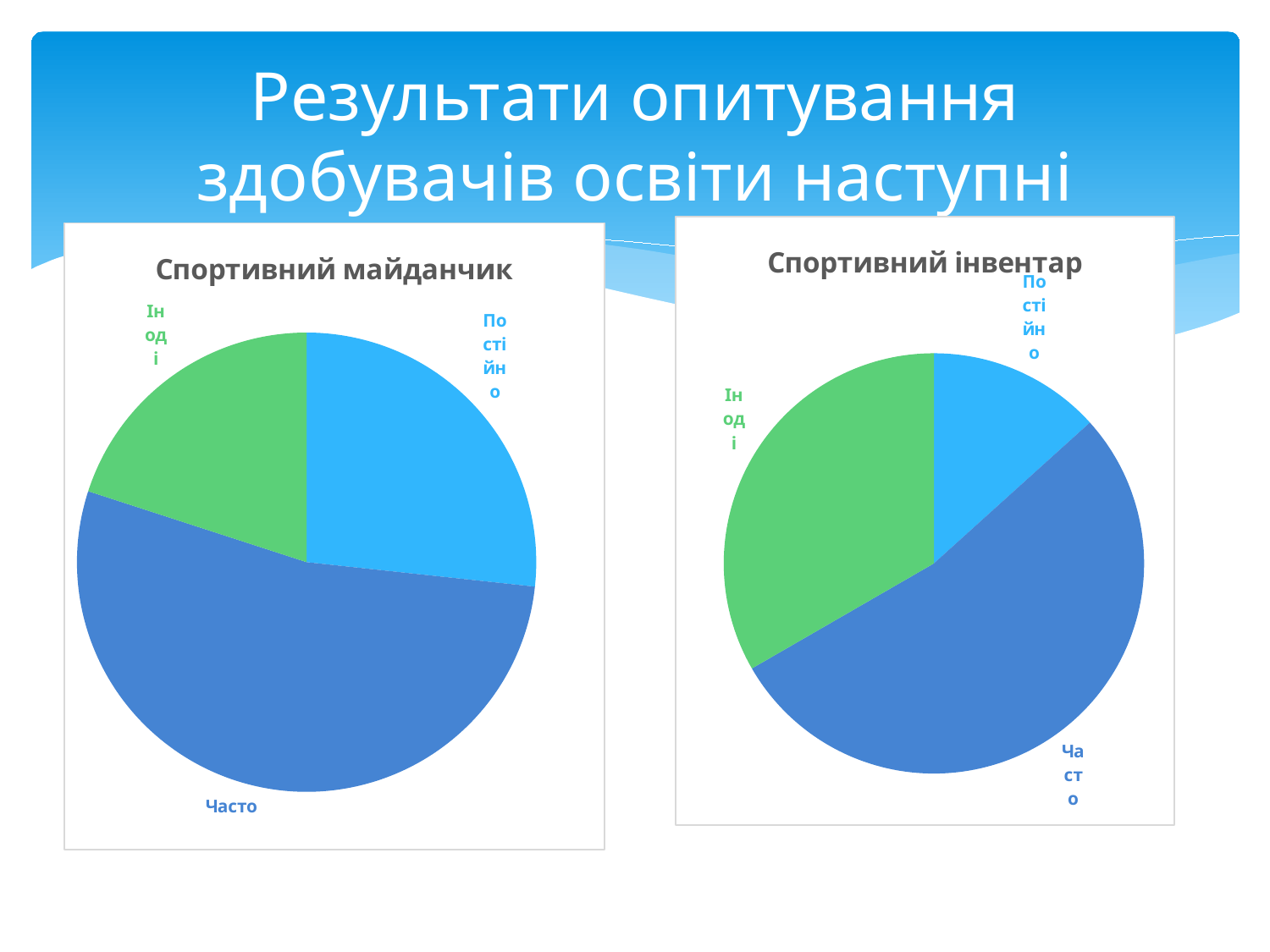
In the "Спортивний інвентар" chart, which category has the smallest slice? Постійно What kind of chart is the "Спортивний майданчик" chart? pie chart In the "Спортивний інвентар" chart, which slice is larger: Часто or Постійно? Часто How many slices does the "Спортивний майданчик" pie chart have? 3 How many slices does the "Спортивний інвентар" pie chart have? 3 In the "Спортивний інвентар" chart, which slice is larger: Іноді or Постійно? Іноді In the "Спортивний інвентар" chart, which category has the largest slice? Часто In the "Спортивний майданчик" chart, which slice is larger: Часто or Іноді? Часто What kind of chart is the "Спортивний інвентар" chart? pie chart In the "Спортивний майданчик" chart, which category has the largest slice? Часто What is the title of the pie chart on the left of the slide? Спортивний майданчик In the "Спортивний майданчик" chart, what colour is the Іноді slice? green